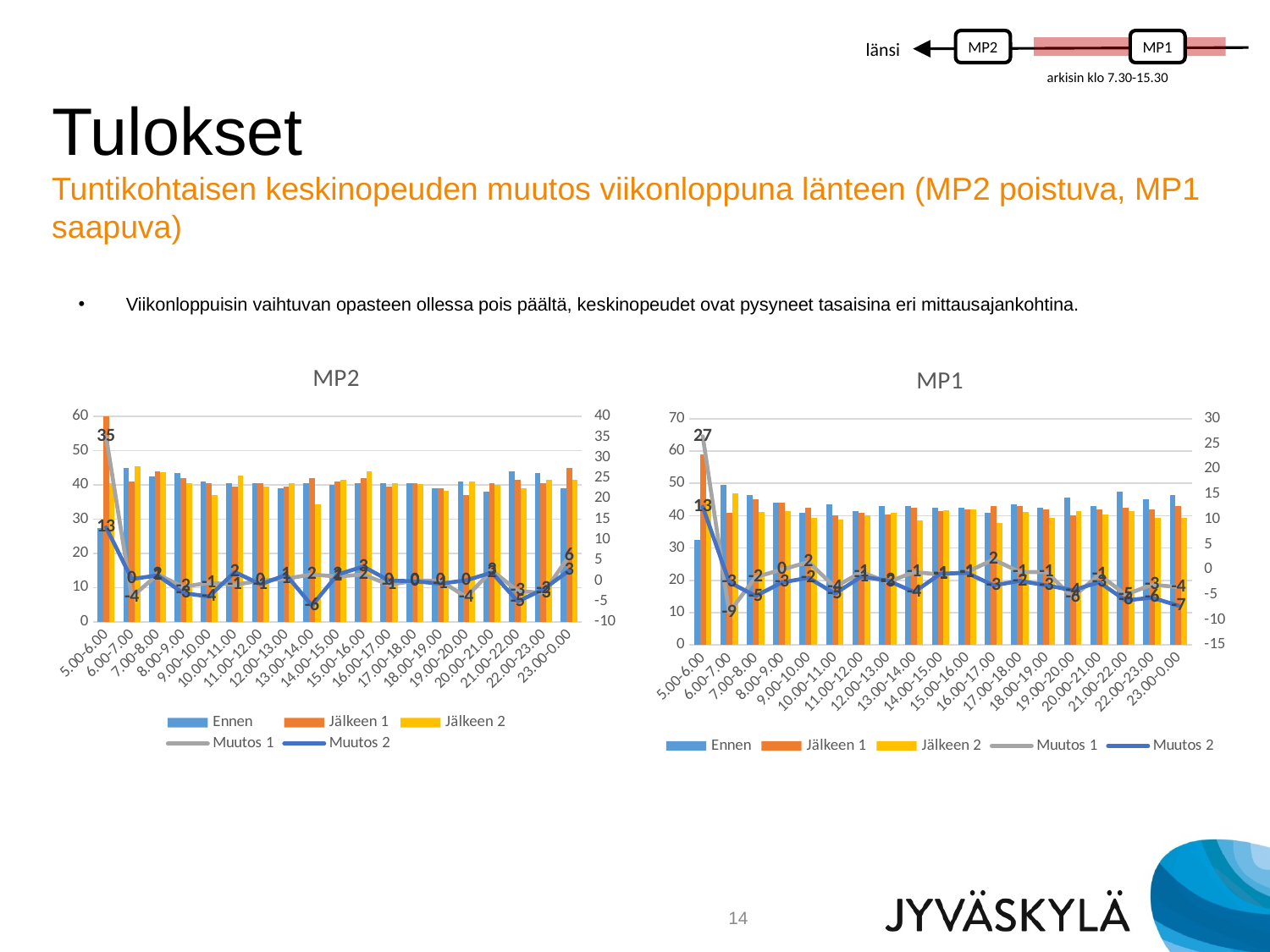
In the MP2 chart, what is the difference between Muutos 1 and Muutos 2 for 5.00-6.00? 22 In the MP1 chart, is the Jälkeen 1 value for 5.00-6.00 greater or less than 50? greater In the MP2 chart, what is the value of Muutos 2 for 5.00-6.00? 13 In the MP1 chart, at which time interval is Muutos 2 lowest? 23.00-0.00 How many time-interval categories are shown on the x axis of the MP1 chart? 19 In the MP1 chart, at which time interval is Muutos 1 highest? 5.00-6.00 In the MP1 chart, what is the value of Muutos 2 for 6.00-7.00? -3 In the MP2 chart, which is larger for 5.00-6.00: Ennen or Jälkeen 1? Jälkeen 1 How many series does the legend of the MP2 chart list? 5 In the MP1 chart, what is the value of Muutos 1 for 5.00-6.00? 27 What kind of chart is the MP2 chart? Combined bar and line chart In the MP2 chart, what is the value of Muutos 1 for 5.00-6.00? 35